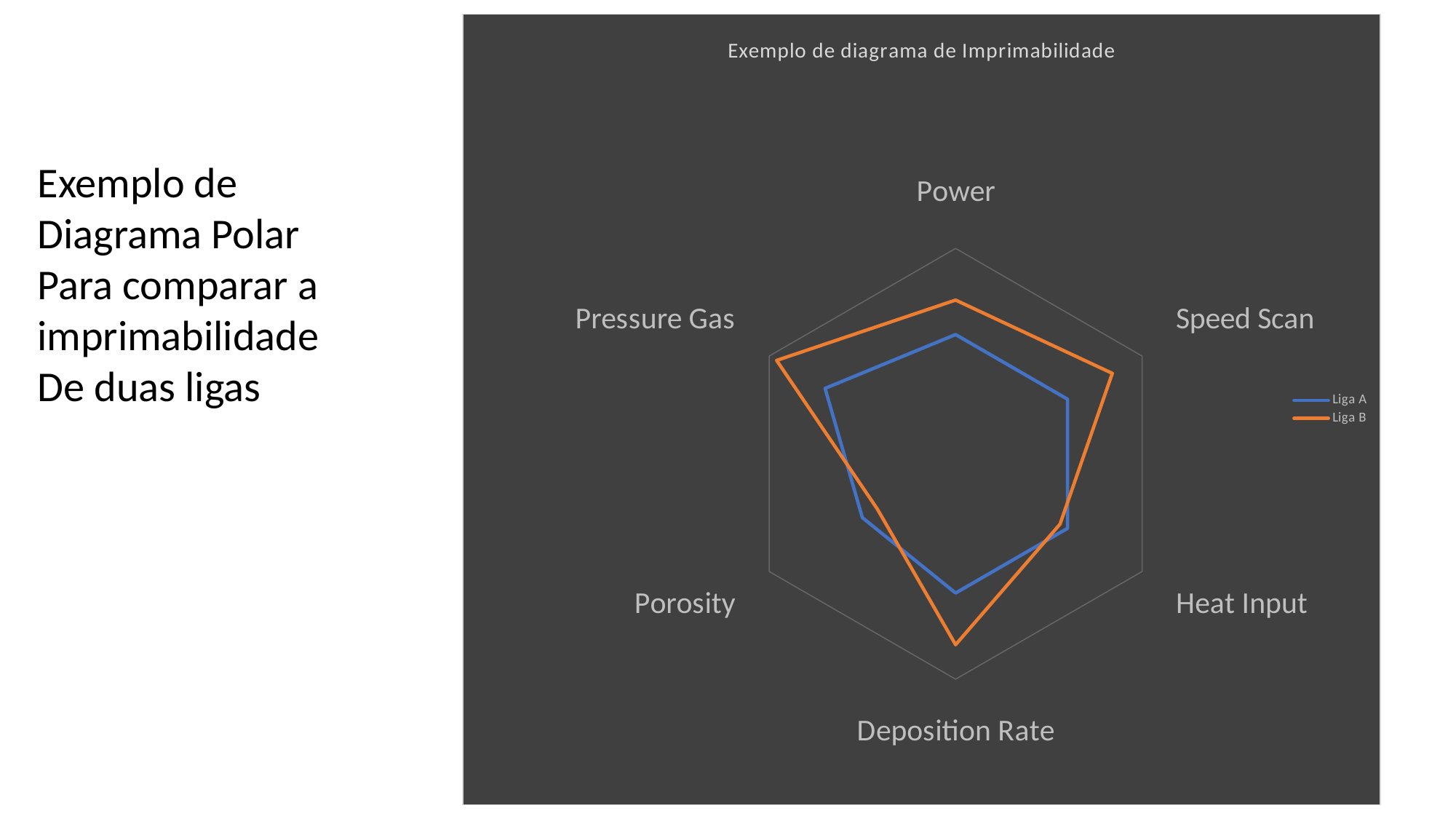
For Power, which series has the larger value, Liga A or Liga B? Liga B For Liga B, which category has the lowest value? Porosity For Porosity, which series has the larger value, Liga A or Liga B? Liga A Which series is drawn in orange? Liga B How many categories (axes) does the radar chart have? 6 For Pressure Gas, which series has the larger value, Liga A or Liga B? Liga B What kind of chart is shown on the slide? Radar chart What is the title of the chart? Exemplo de diagrama de Imprimabilidade How many series does the legend list? 2